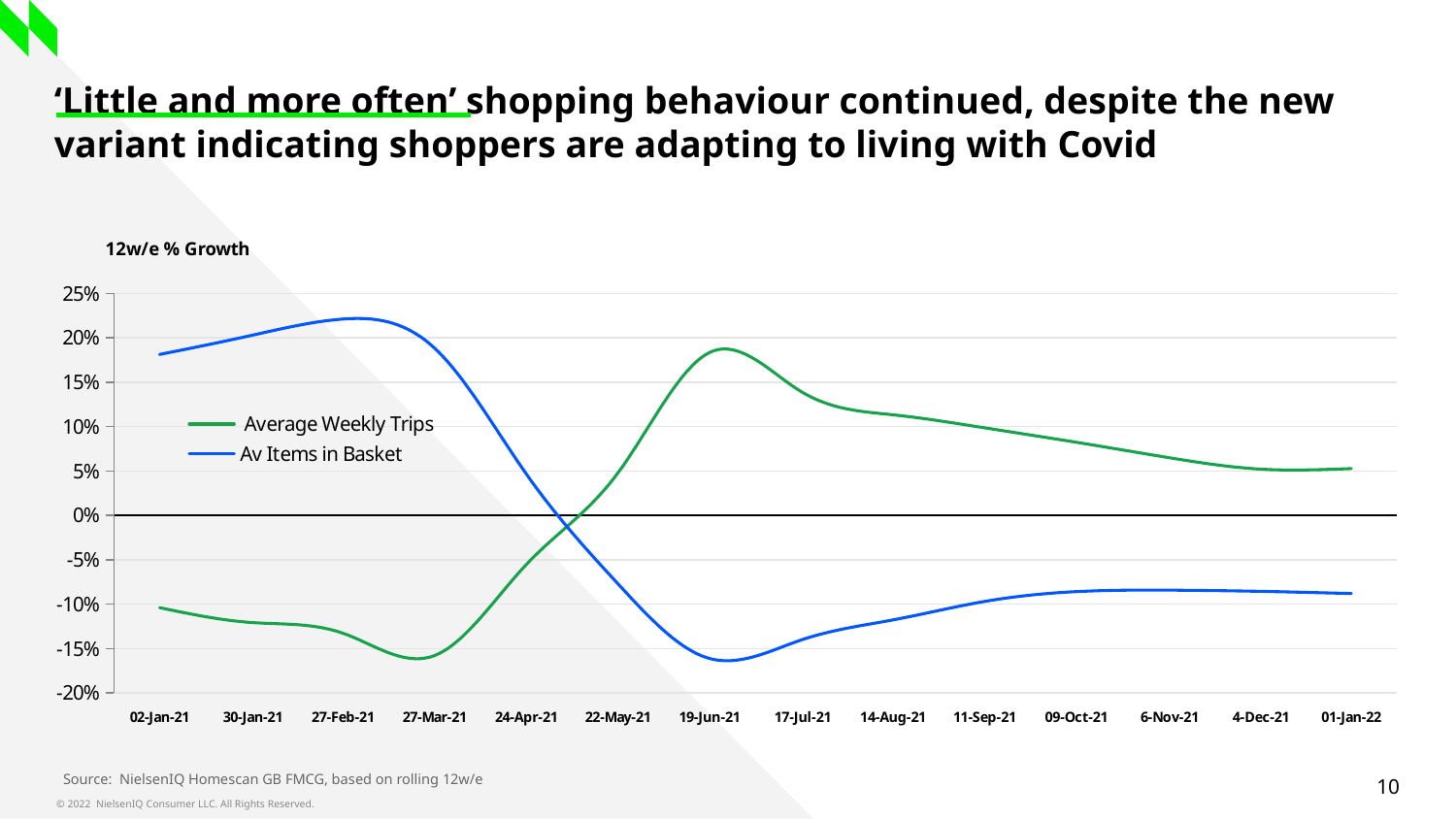
What is the title of the chart? 12w/e % Growth At 01-Jan-22, which series has the higher value, Average Weekly Trips or Av Items in Basket? Average Weekly Trips At 02-Jan-21, which series has the higher value, Average Weekly Trips or Av Items in Basket? Av Items in Basket How many series does the legend list? 2 Is the value for Average Weekly Trips at 19-Jun-21 greater or less than 15%? greater Does the Average Weekly Trips line rise or fall between 19-Jun-21 and 01-Jan-22? Fall At which date does the Average Weekly Trips line reach its highest value? 19-Jun-21 How many dates are labelled along the x axis? 14 Is the value for Av Items in Basket at 19-Jun-21 greater or less than -15%? less What kind of chart is shown on the slide? Line chart Is the value for Av Items in Basket at 02-Jan-21 greater or less than 15%? greater Which colour is used for the Av Items in Basket line? Blue